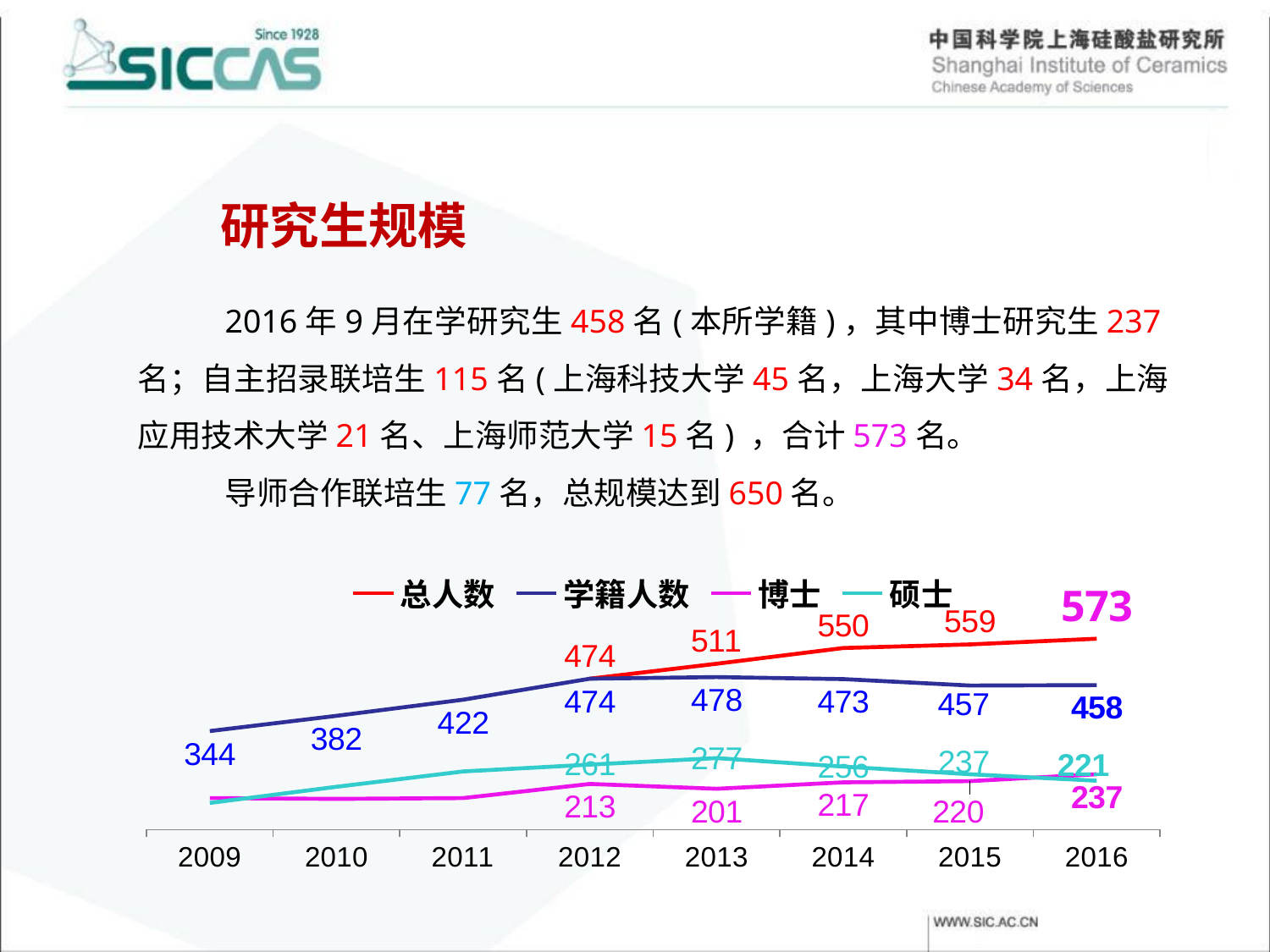
Does 总人数 rise or fall from 2012 to 2016? rise In which year does 学籍人数 reach its highest value? 2013 What is the difference between 总人数 and 学籍人数 in 2016? 115 What is the value of 硕士 in 2013? 277 What is the value of 学籍人数 in 2009? 344 In 2016, which is larger, 博士 or 硕士? 博士 How many series does the chart legend list? 4 What is the value of 博士 in 2013? 201 What is the value of 总人数 in 2016? 573 How many years are shown on the x axis of the chart? 8 What kind of chart is shown on the slide? line chart